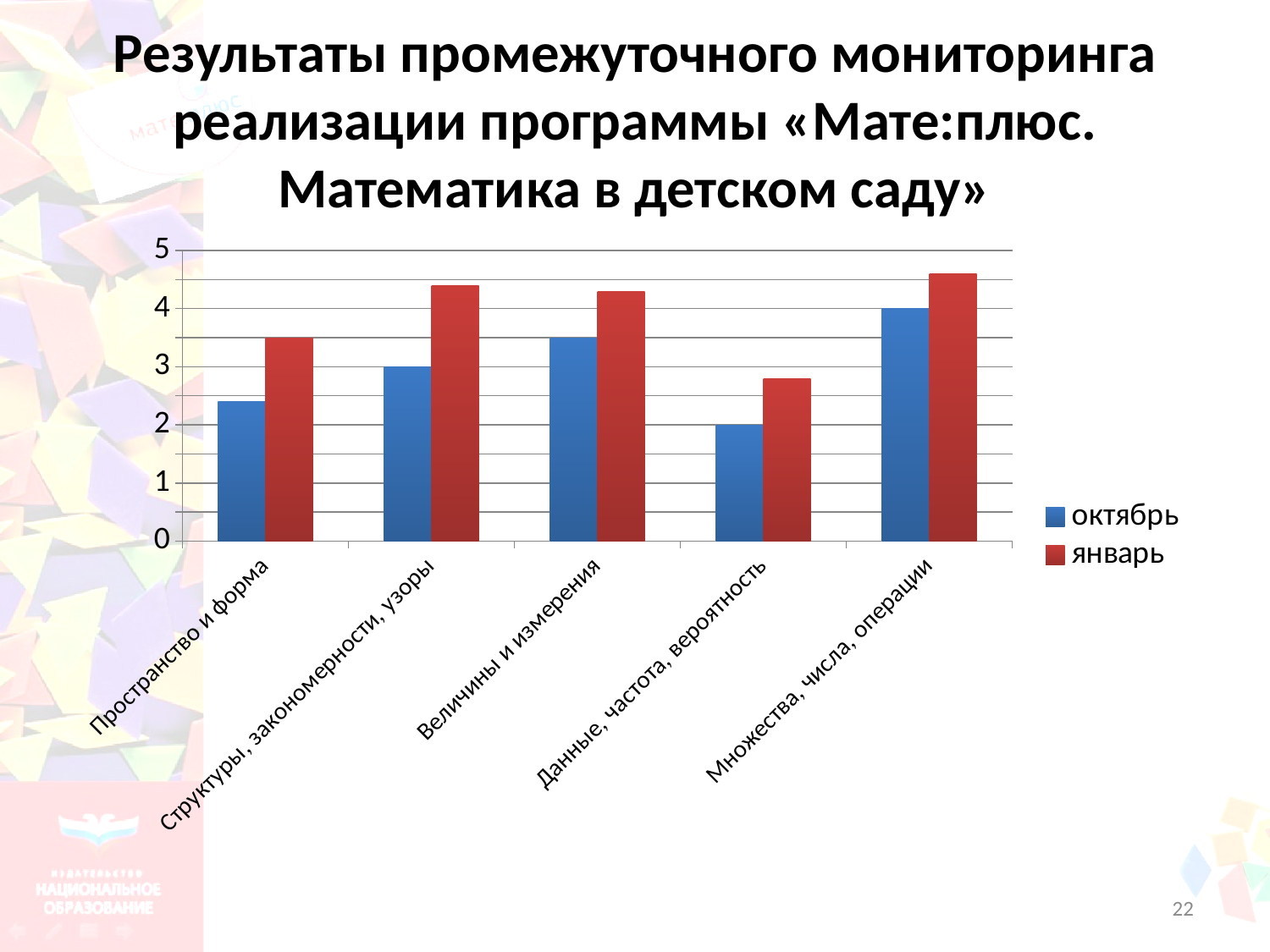
What is the October (октябрь) value for Множества, числа, операции? 4 Is the January (январь) value for Данные, частота, вероятность greater or less than 3? less Which category has the highest October (октябрь) value? Множества, числа, операции What is the October (октябрь) value for Структуры, закономерности, узоры? 3 What kind of chart is shown on the slide? bar chart Which series is shown in red? январь What is the October (октябрь) value for Данные, частота, вероятность? 2 For Величины и измерения, which is larger: the October value or the January value? January (январь) Which category has the lowest January (январь) value? Данные, частота, вероятность Is the January (январь) value for Пространство и форма greater or less than 3? greater How many categories are shown on the x axis? 5 How many series does the legend list? 2